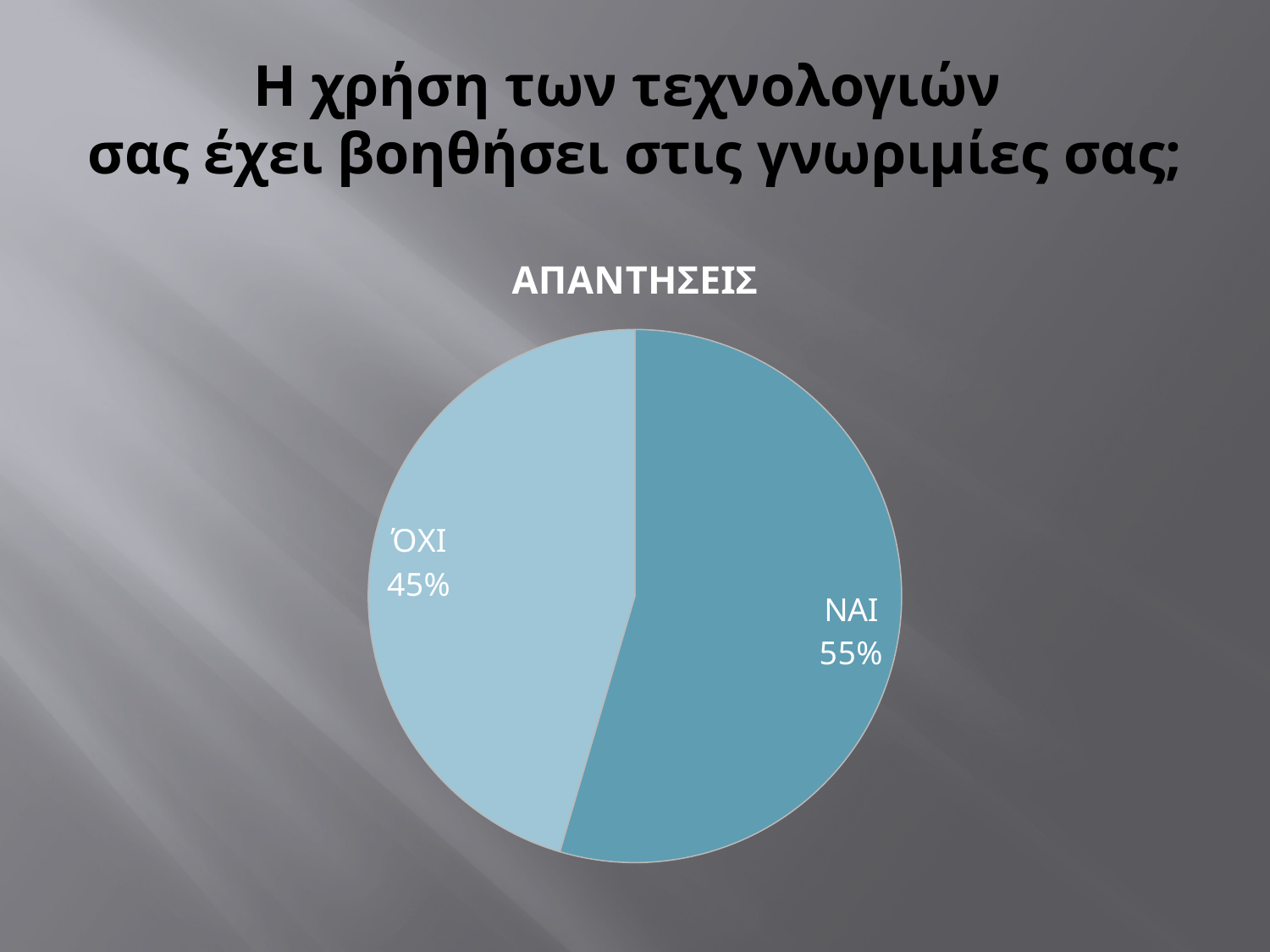
Which slice is the smallest? ΌΧΙ Which is larger, the ΝΑΙ slice or the ΌΧΙ slice? ΝΑΙ What share of the pie does ΌΧΙ take? 45% Which slice is shown in the lighter blue colour? ΌΧΙ Is the share for ΝΑΙ greater or less than 50%? greater What kind of chart is shown on the slide? pie chart What is the difference in percentage points between the ΝΑΙ and ΌΧΙ slices? 10% What share of the pie does ΝΑΙ take? 55% What is the chart's title? ΑΠΑΝΤΗΣΕΙΣ How many slices does the pie chart have? 2 Which slice is the largest? ΝΑΙ